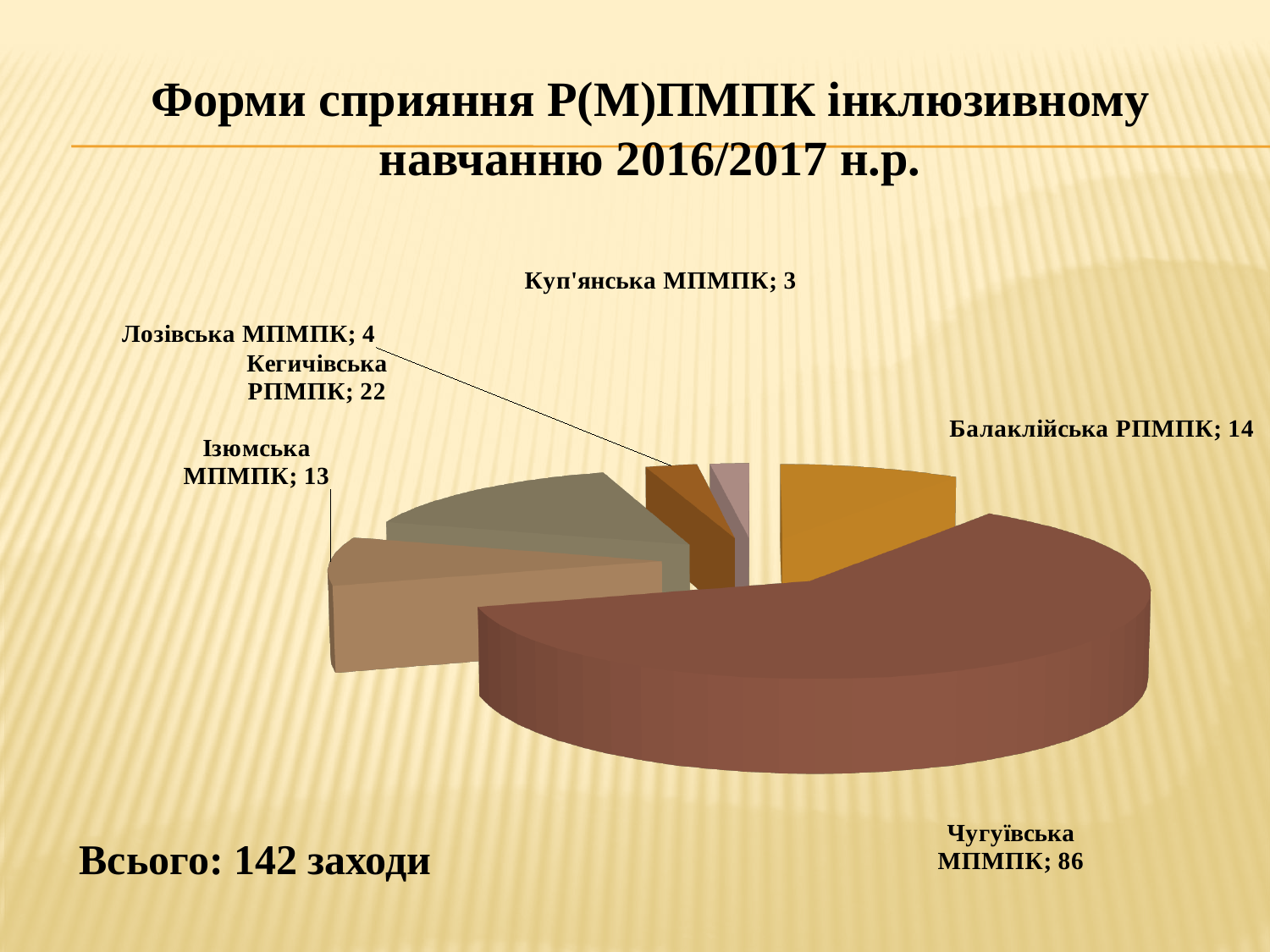
How many categories are shown in the pie chart? 6 What total number of events (заходи) is stated on the slide? 142 What is the value for Чугуївська МПМПК? 86 What is the value for Балаклійська РПМПК? 14 What is the value for Ізюмська МПМПК? 13 Which category has the smallest slice of the pie? Куп'янська МПМПК Which is larger, the value for Балаклійська РПМПК or the value for Ізюмська МПМПК? Балаклійська РПМПК What is the difference between the values for Чугуївська МПМПК and Кегичівська РПМПК? 64 What type of chart is shown on the slide? pie chart What is the value for Кегичівська РПМПК? 22 Which category has the largest slice of the pie? Чугуївська МПМПК What is the value for Лозівська МПМПК? 4